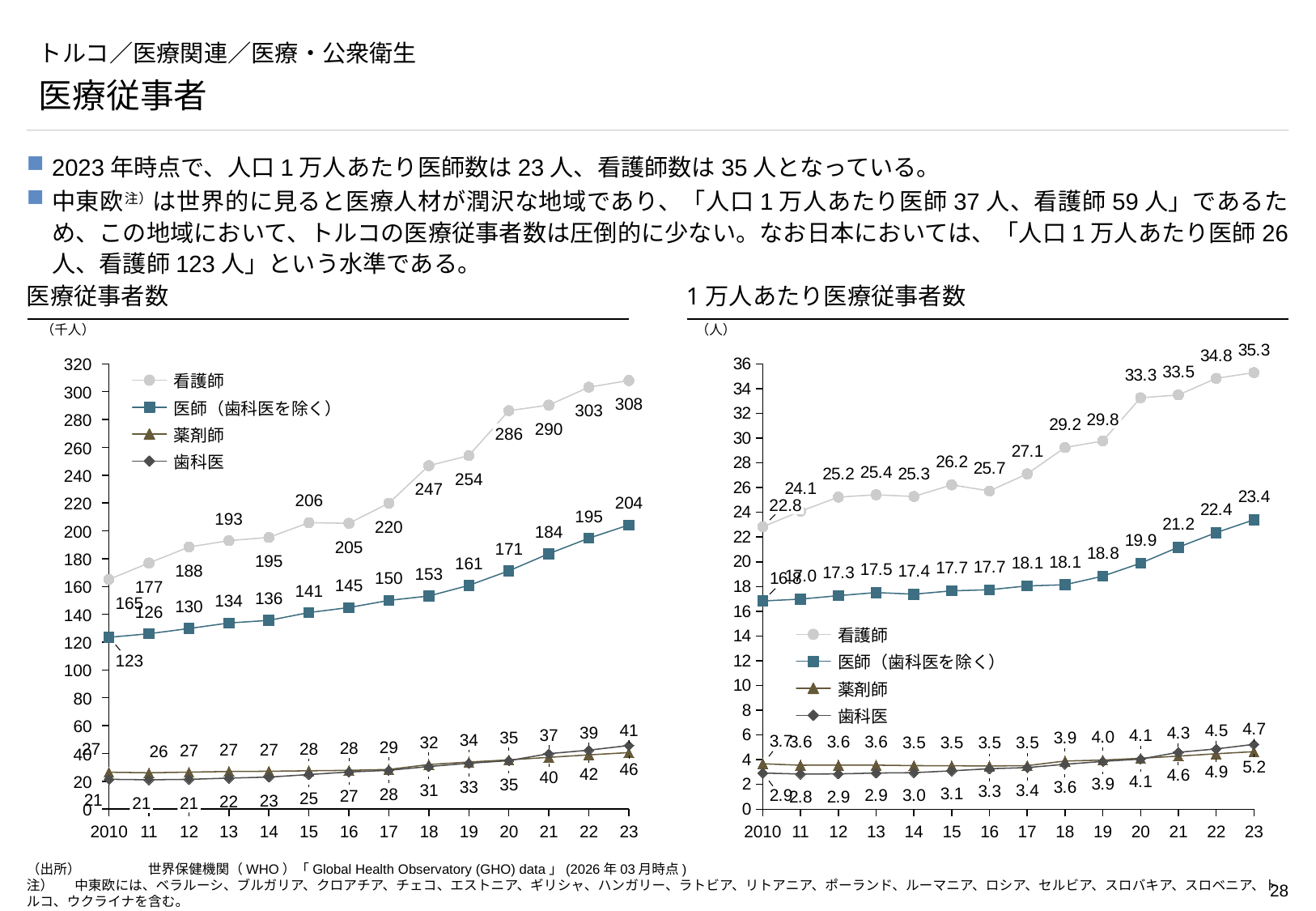
In the left chart (医療従事者数), what is the difference between the 看護師 values in 2023 and 2010? 143 In the right chart (1万人あたり医療従事者数), what is the value for 医師（歯科医を除く） in 2023? 23.4 In the left chart (医療従事者数), what is the value for 医師（歯科医を除く） in 2020? 171 In the right chart (1万人あたり医療従事者数), does the 看護師 series generally rise or fall from 2010 to 2023? rise How many series does the legend of the left chart (医療従事者数) list? 4 In the left chart (医療従事者数), which series has the highest value in 2023? 看護師 In the left chart (医療従事者数), what is the value for 医師（歯科医を除く） in 2010? 123 What kind of chart is the right chart (1万人あたり医療従事者数)? line chart In the left chart (医療従事者数), what is the value for 看護師 in 2023? 308 In the right chart (1万人あたり医療従事者数), what is the value for 看護師 in 2010? 22.8 In the right chart (1万人あたり医療従事者数), what is the difference between the 看護師 and 医師（歯科医を除く） values in 2023? 11.9 In the right chart (1万人あたり医療従事者数), what is the value for 看護師 in 2023? 35.3